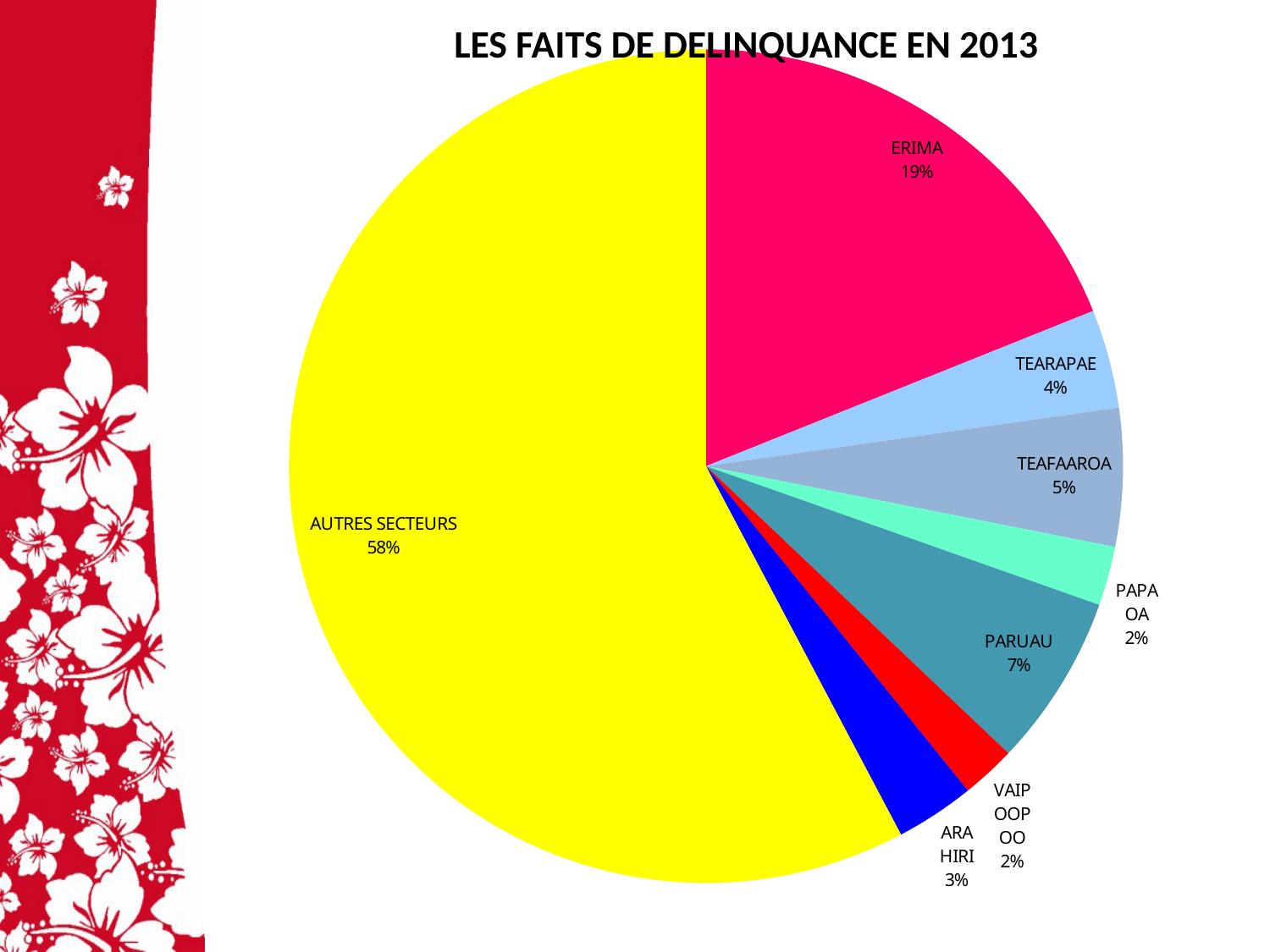
What is the difference in percentage points between ERIMA and PARUAU? 12 What colour is the AUTRES SECTEURS slice? yellow What is the value shown for ERIMA? 19% How many slices does the pie chart have? 8 What is the value shown for PARUAU? 7% What is the value shown for ARAHIRI? 3% What share of the pie does AUTRES SECTEURS represent? 58% What is the value shown for TEAFAAROA? 5% Which is larger, the slice for TEARAPAE or the slice for TEAFAAROA? TEAFAAROA Which sector has the largest slice of the pie? AUTRES SECTEURS What is the title of the chart? LES FAITS DE DELINQUANCE EN 2013 What kind of chart is shown on the slide? pie chart